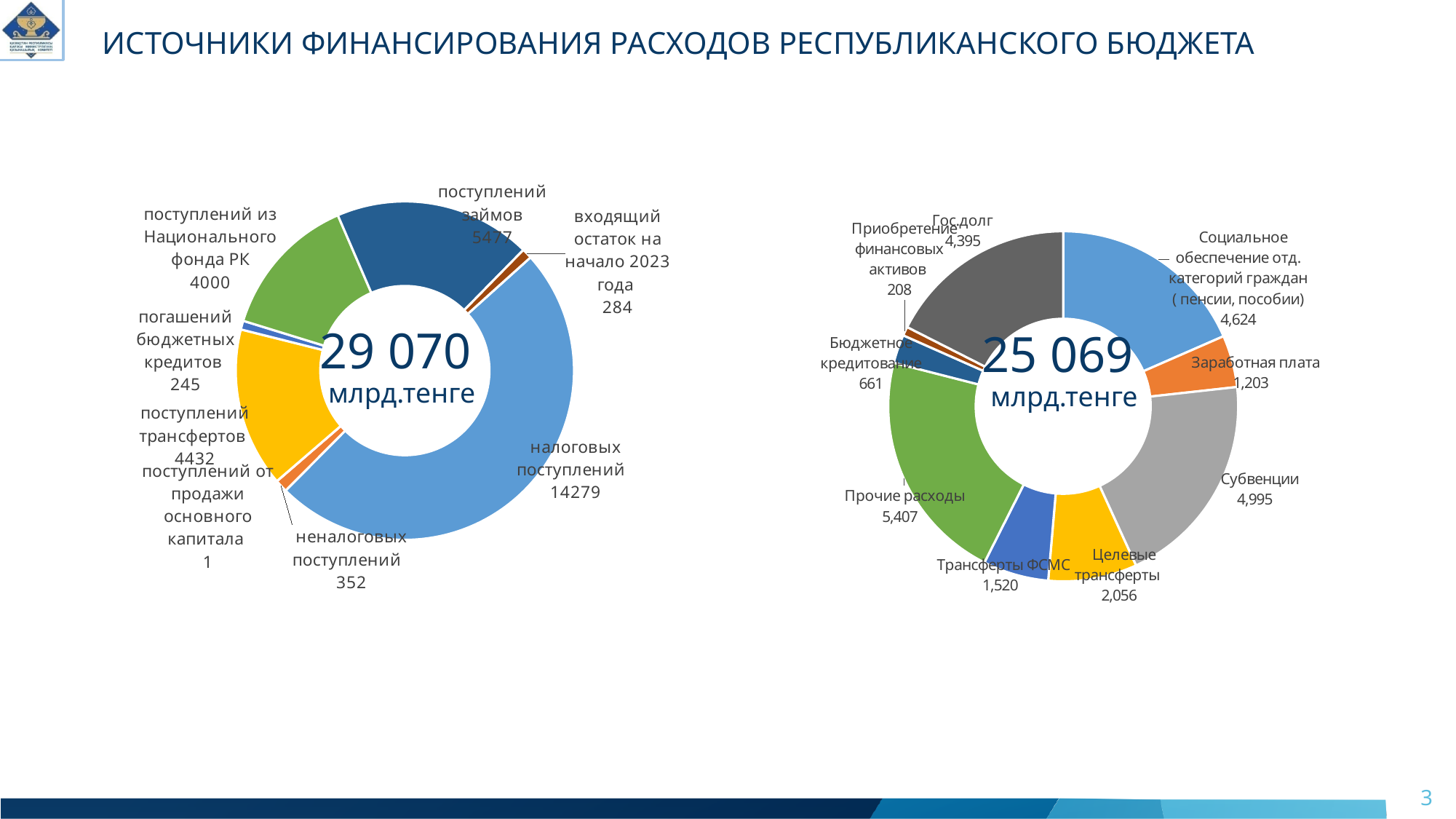
On the right chart (25 069 млрд.тенге), which category has the smallest value? Приобретение финансовых активов On the left chart (29 070 млрд.тенге), which category has the largest value? налоговых поступлений On the right chart (25 069 млрд.тенге), which category has the largest value? Прочие расходы On the right chart (25 069 млрд.тенге), what is the value for Субвенции? 4,995 What kind of chart is the left chart (29 070 млрд.тенге)? Doughnut (pie) chart On the left chart (29 070 млрд.тенге), what is the value for налоговых поступлений? 14279 On the right chart (25 069 млрд.тенге), which is larger: Целевые трансферты or Трансферты ФСМС? Целевые трансферты On the left chart (29 070 млрд.тенге), which category has the smallest value? поступлений от продажи основного капитала On the left chart (29 070 млрд.тенге), what is the difference between поступлений займов and поступлений трансфертов? 1045 How many categories does the left chart (29 070 млрд.тенге) show? 8 On the right chart (25 069 млрд.тенге), what is the value for Гос.долг? 4,395 How many categories does the right chart (25 069 млрд.тенге) show? 9